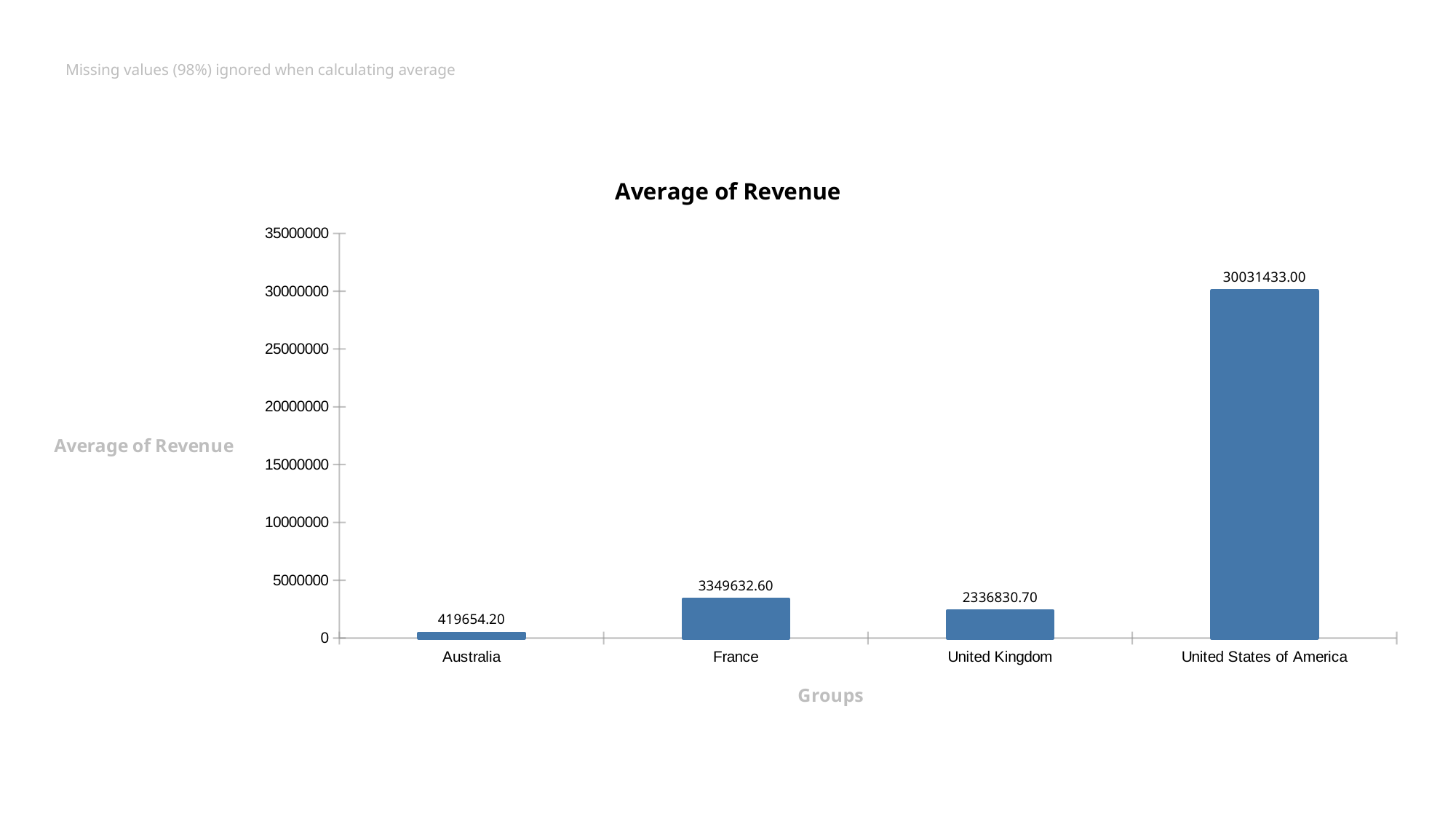
Which has a higher average revenue, France or the United Kingdom? France Which group has the lowest average revenue? Australia What is the difference between the average revenue of France and the United Kingdom? 1012801.90 What is the title of the chart? Average of Revenue What is the average revenue for the United Kingdom? 2336830.70 What is the average revenue for Australia? 419654.20 Is the value for the United States of America greater or less than 25000000? greater What is the average revenue for the United States of America? 30031433.00 Which group has the highest average revenue? United States of America What kind of chart is shown on the slide? Bar chart What is the average revenue for France? 3349632.60 How many groups are shown on the x axis? 4